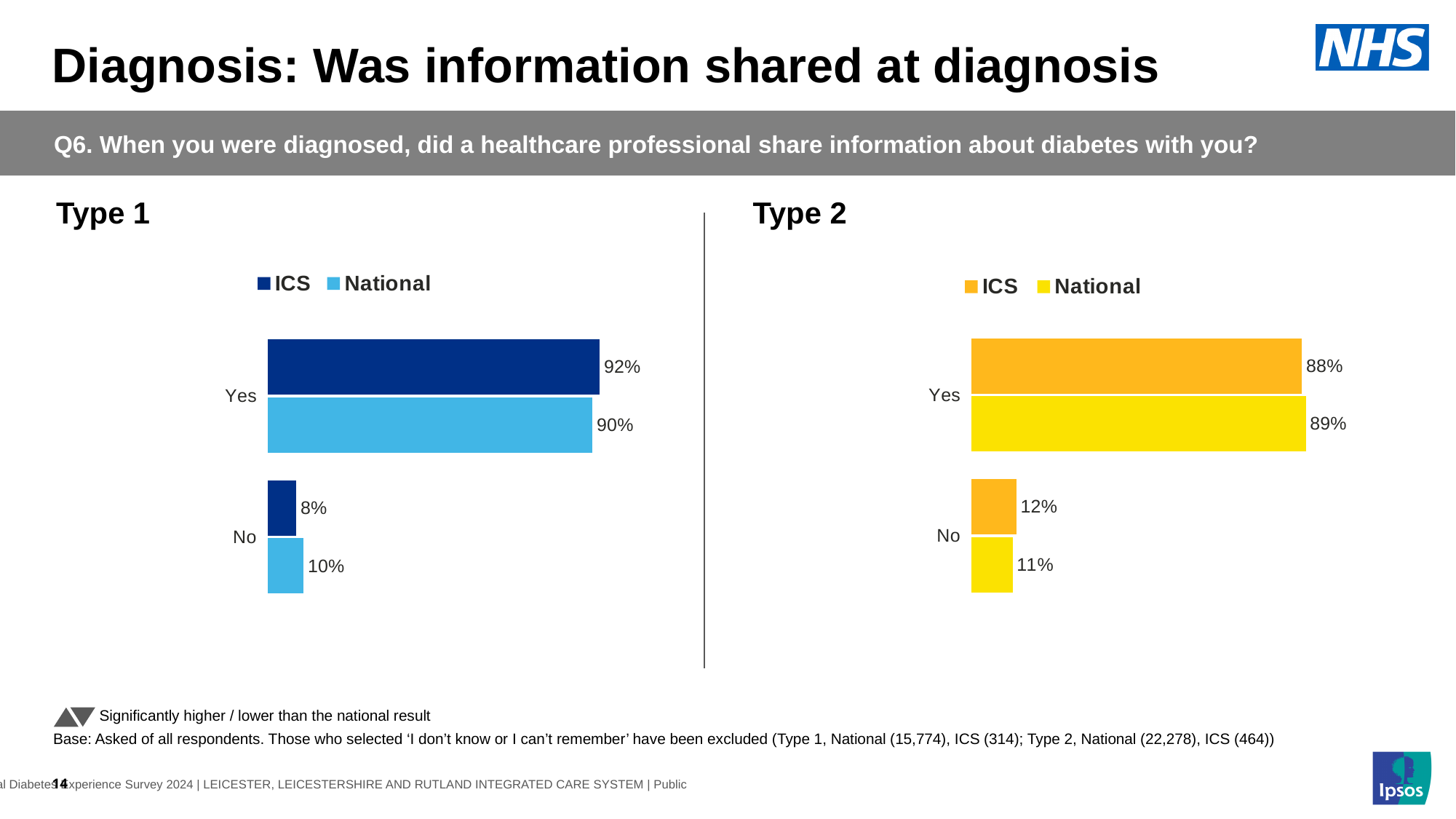
How many categories are shown in the Type 2 chart? 2 What colour are the ICS bars in the Type 2 chart? Orange How many series does the legend of the Type 1 chart list? 2 In the Type 1 chart, what is the ICS value for Yes? 92% What kind of chart is the Type 1 chart? Bar chart In the Type 1 chart, which is larger for No, ICS or National? National In the Type 1 chart, what is the difference between the ICS and National values for Yes? 2 percentage points In the Type 1 chart, what is the National value for No? 10% In the Type 2 chart, which is larger for Yes, ICS or National? National In the Type 2 chart, what is the National value for No? 11% In the Type 2 chart, what is the ICS value for Yes? 88% In the Type 2 chart, what is the difference between the ICS and National values for No? 1 percentage point